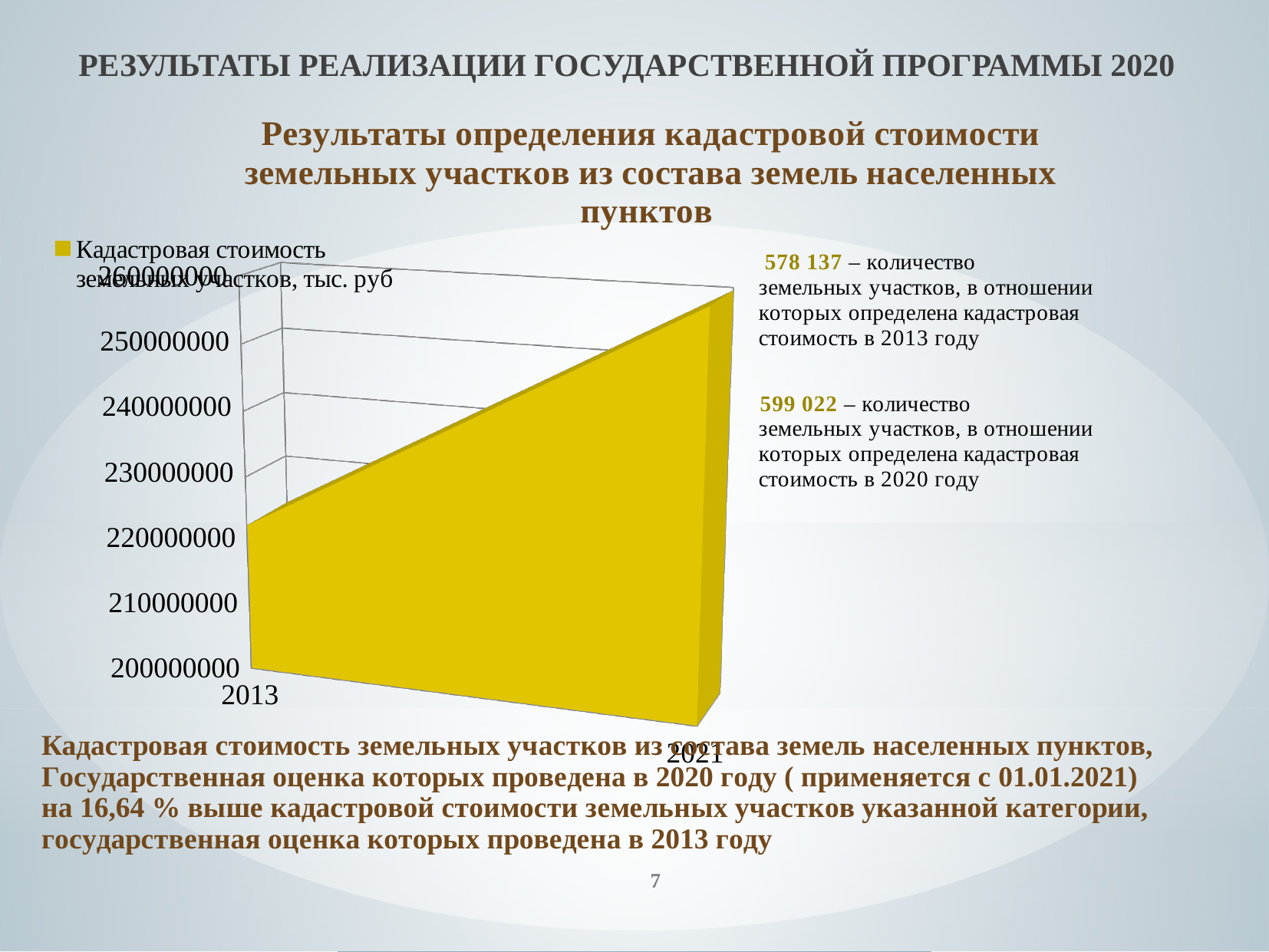
Which year shows the highest cadastral value on the chart? 2021 What kind of chart is shown on the slide? area chart Which year has the higher cadastral value, 2013 or 2021? 2021 Does the cadastral value rise or fall from 2013 to 2021? rise Is the value for 2013 greater or less than 230000000? less How many series does the chart legend list? 1 Is the value for 2021 greater or less than 250000000? greater How many data points (years) are plotted on the x axis of the chart? 2 Which year shows the lowest cadastral value on the chart? 2013 Is the value for 2013 greater or less than 210000000? greater Which two years are labelled on the x axis of the chart? 2013 and 2021 What is the series name shown in the chart legend? Кадастровая стоимость земельных участков, тыс. руб